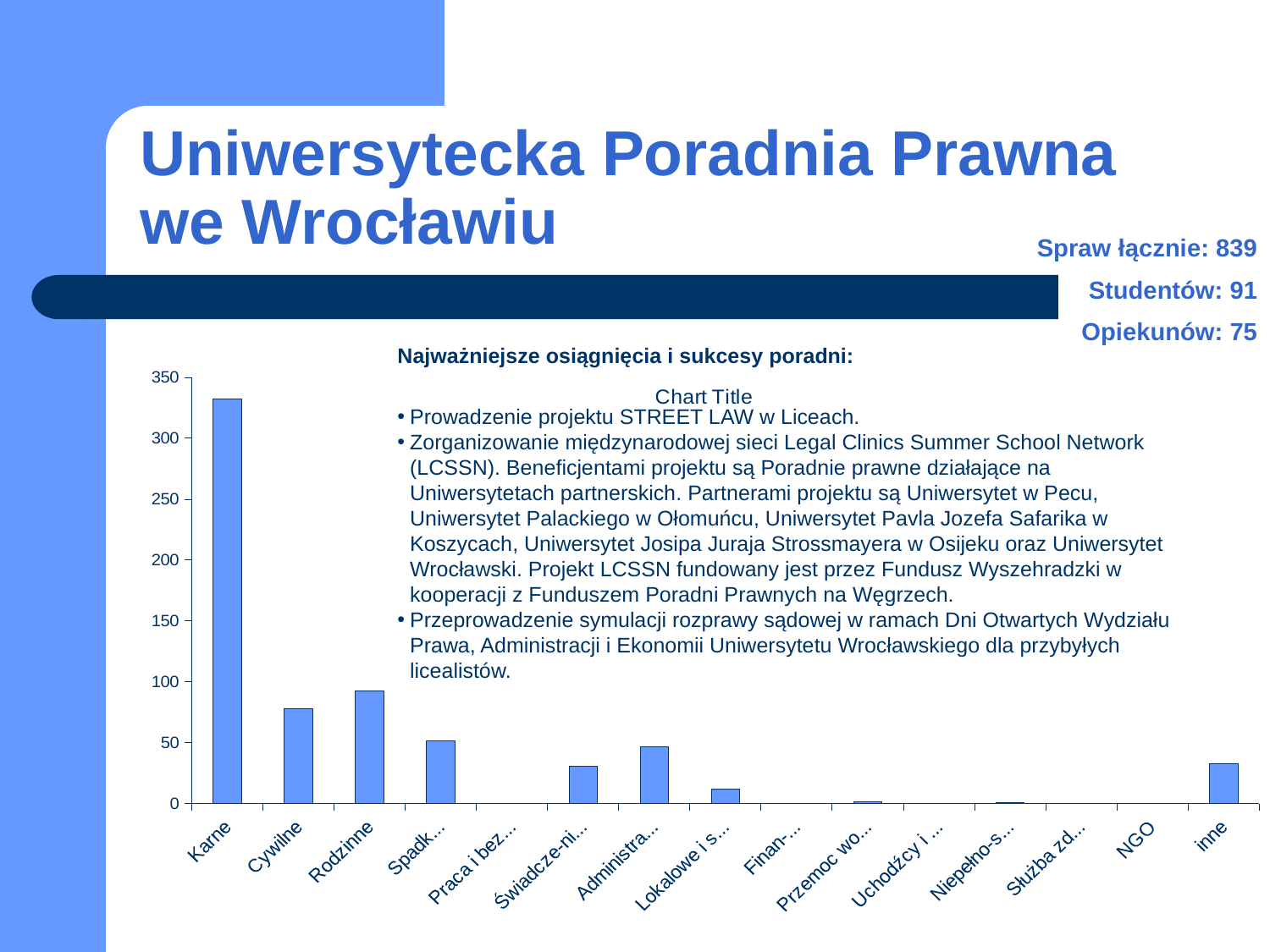
What kind of chart is shown on the slide? bar chart Is the value for Cywilne greater or less than 100? less Which is larger, the value for Administra... or the value for Lokalowe i s...? Administra... What is the title shown above the chart? Chart Title Which is larger, the value for Karne or the value for Cywilne? Karne Is the value for inne greater or less than 50? less Which is larger, the value for Rodzinne or the value for Cywilne? Rodzinne Which category has the highest value in the chart? Karne Is the value for Karne greater or less than 300? greater How many categories are shown on the x axis of the chart? 15